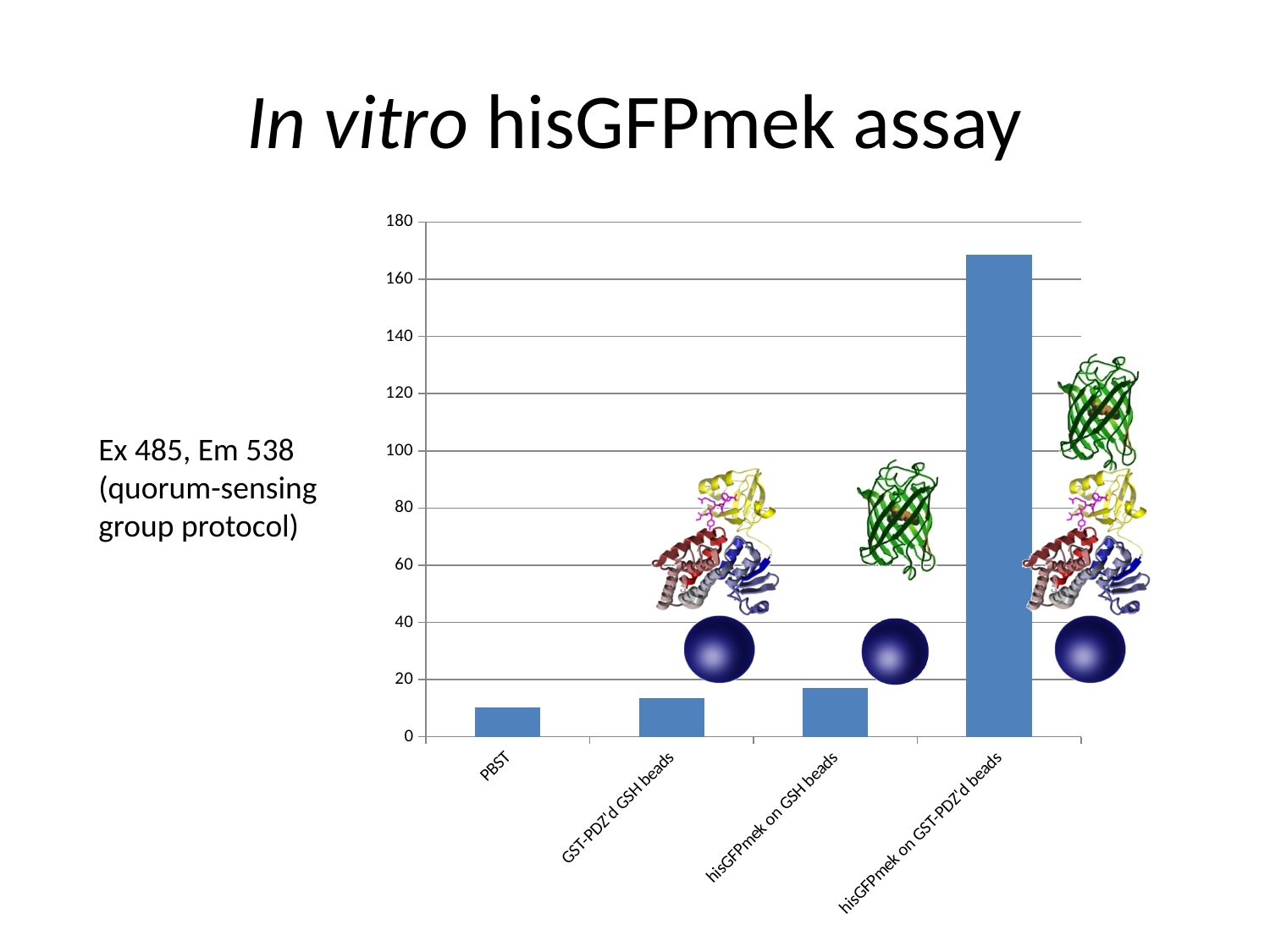
Which category has the highest bar in the chart? hisGFPmek on GST-PDZ'd beads What is the maximum value shown on the y axis of the chart? 180 Is the value for GST-PDZ'd GSH beads greater or less than 20? less Do the bar values rise or fall from left to right along the x axis? rise Which is larger, the value for hisGFPmek on GSH beads or the value for PBST? hisGFPmek on GSH beads Is the value for hisGFPmek on GST-PDZ'd beads greater or less than 160? greater Is the value for PBST greater or less than 20? less What kind of chart is shown on the slide? bar chart Which is larger, the value for hisGFPmek on GST-PDZ'd beads or the value for hisGFPmek on GSH beads? hisGFPmek on GST-PDZ'd beads How many categories are plotted on the x axis of the chart? 4 Which category has the lowest bar in the chart? PBST